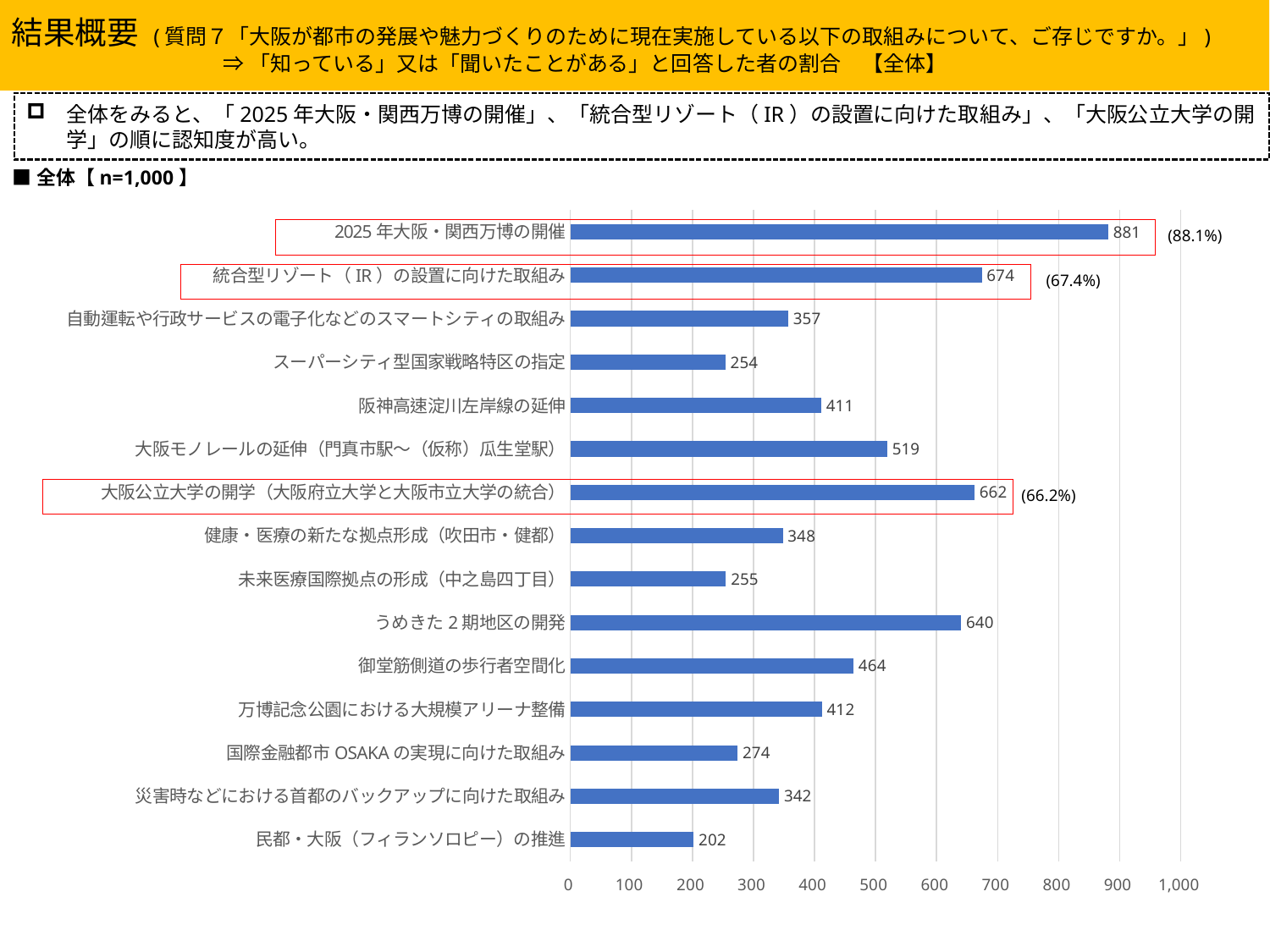
Is the value for うめきた２期地区の開発 greater or less than 600? greater Which is larger: the value for 大阪モノレールの延伸（門真市駅～（仮称）瓜生堂駅） or the value for 御堂筋側道の歩行者空間化? 大阪モノレールの延伸（門真市駅～（仮称）瓜生堂駅） What is the sample size (n) stated above the chart? n=1,000 What is the value for うめきた２期地区の開発? 640 What percentage is shown next to the bar for 大阪公立大学の開学（大阪府立大学と大阪市立大学の統合）? 66.2% What is the difference between the values for 2025年大阪・関西万博の開催 and 統合型リゾート（IR）の設置に向けた取組み? 207 What is the value for 2025年大阪・関西万博の開催? 881 How many categories are shown in the chart? 15 What is the value for 民都・大阪（フィランソロピー）の推進? 202 What kind of chart is shown on the slide? bar chart Which category has the lowest value? 民都・大阪（フィランソロピー）の推進 Which category has the highest value? 2025年大阪・関西万博の開催